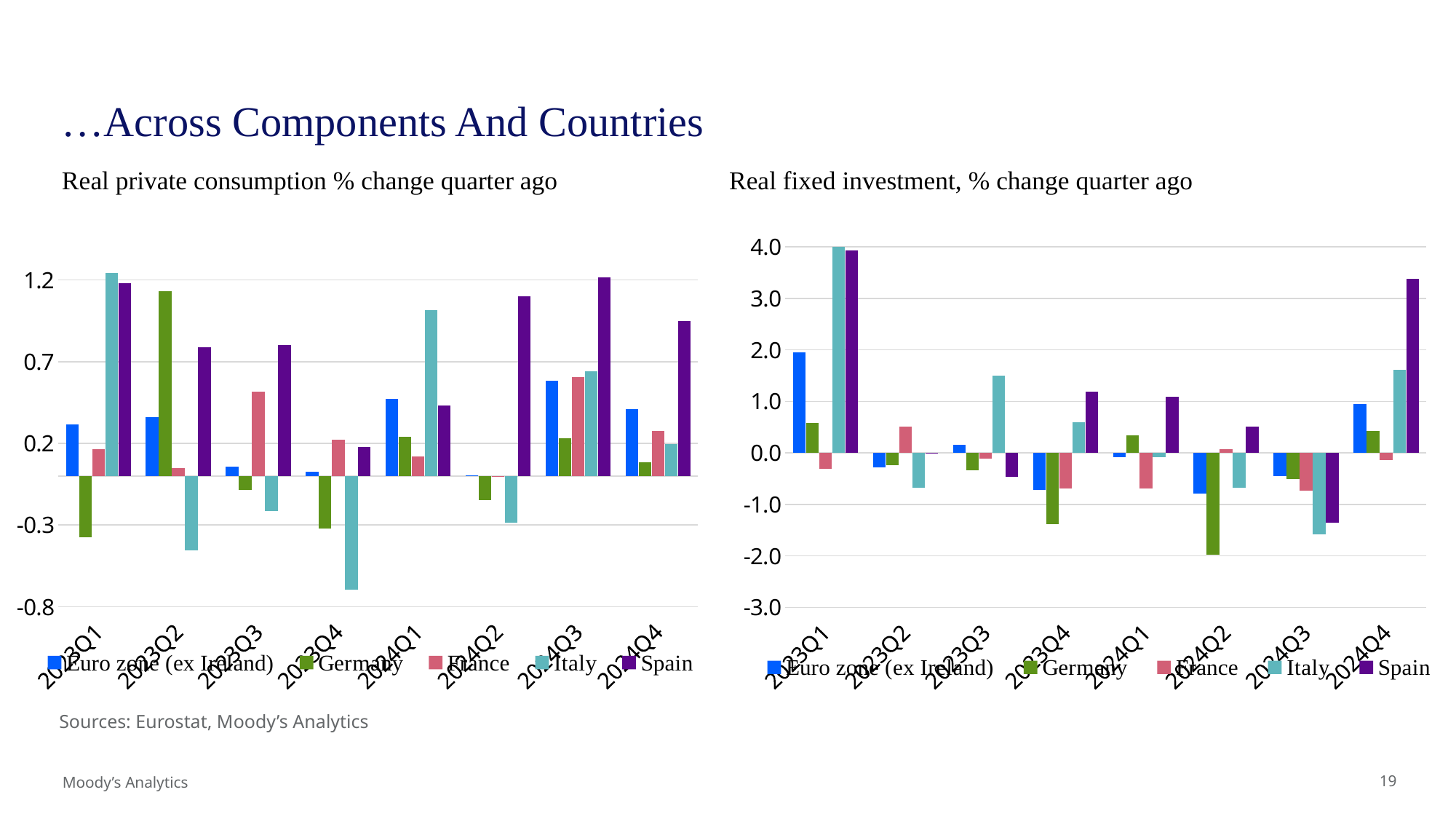
How many series does the legend of the 'Real fixed investment, % change quarter ago' chart list? 5 Which colour represents Spain in the legend of the 'Real private consumption % change quarter ago' chart? purple In the 'Real fixed investment, % change quarter ago' chart, is the value for Euro zone (ex Ireland) in 2023Q1 greater or less than 1.0? greater In the 'Real private consumption % change quarter ago' chart, is the value for Italy in 2023Q4 greater or less than -0.3? less In the 'Real private consumption % change quarter ago' chart, which country and quarter has the lowest bar? Italy, 2023Q4 In the 'Real fixed investment, % change quarter ago' chart, which country and quarter has the lowest bar? Germany, 2024Q2 In the 'Real private consumption % change quarter ago' chart, which is larger in 2024Q1: Italy or Spain? Italy In the 'Real fixed investment, % change quarter ago' chart, which is larger in 2023Q4: Germany or France? France How many quarters are shown on the x axis of the 'Real private consumption % change quarter ago' chart? 8 In the 'Real fixed investment, % change quarter ago' chart, is the value for Spain in 2024Q4 greater or less than 3.0? greater What kind of chart is the 'Real private consumption % change quarter ago' chart? bar chart